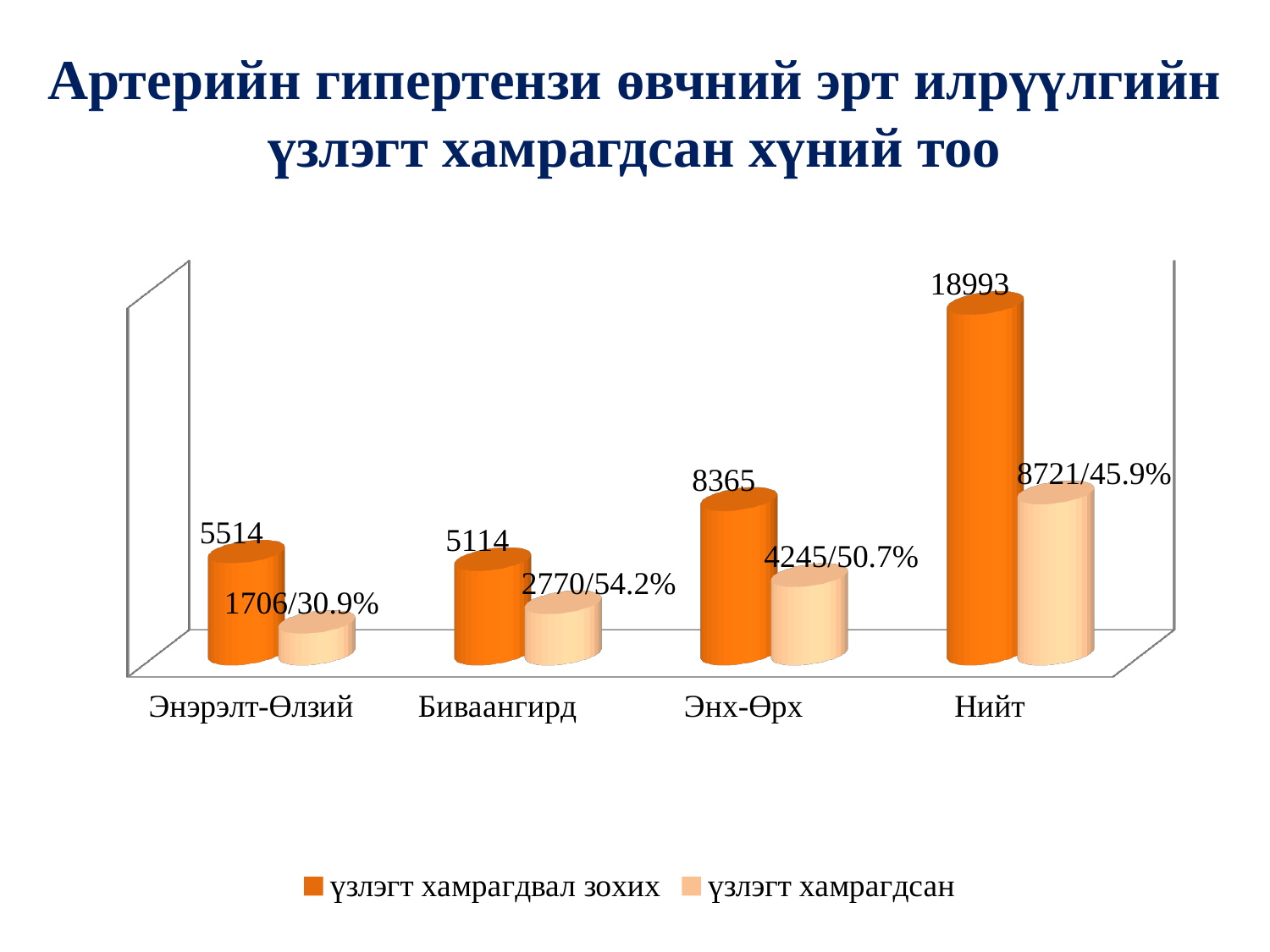
What data label is shown for Энэрэлт-Өлзий in the үзлэгт хамрагдсан series? 1706/30.9% What percentage is shown for Нийт in the үзлэгт хамрагдсан series? 45.9% Which category has the lowest value in the үзлэгт хамрагдсан series? Энэрэлт-Өлзий Which category has the highest value in the үзлэгт хамрагдвал зохих series? Нийт What is the value for Энх-Өрх in the үзлэгт хамрагдвал зохих series? 8365 How many categories are shown on the x axis? 4 What kind of chart is shown on the slide? Bar chart What is the difference between the үзлэгт хамрагдвал зохих values for Энх-Өрх and Биваангирд? 3251 What data label is shown for Биваангирд in the үзлэгт хамрагдсан series? 2770/54.2% How many series does the legend list? 2 What is the value for Нийт in the үзлэгт хамрагдвал зохих series? 18993 Which is larger: the үзлэгт хамрагдвал зохих value for Энэрэлт-Өлзий or for Биваангирд? Энэрэлт-Өлзий